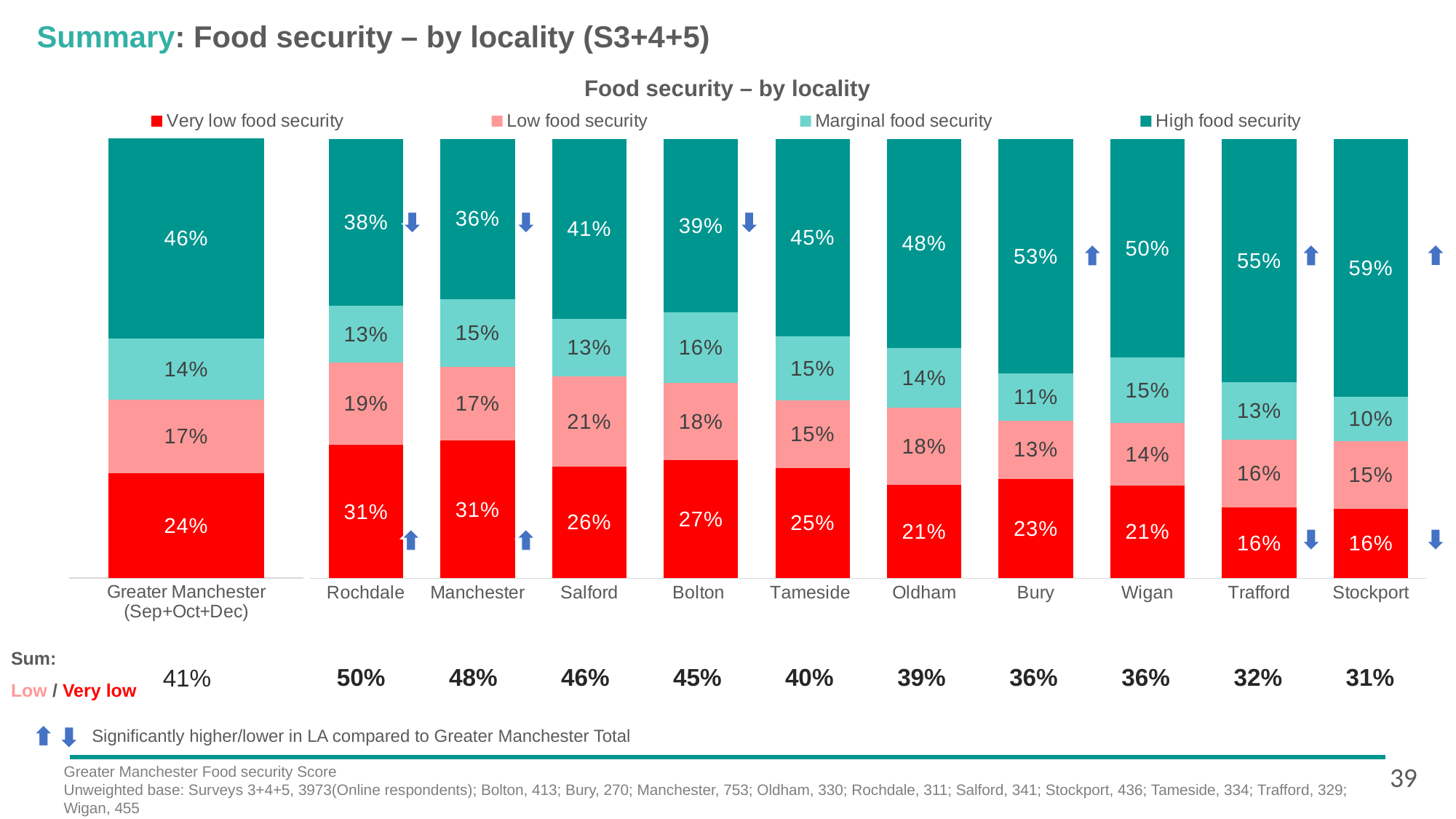
Which locality has the highest High food security value? Stockport What kind of chart is shown on the slide? Stacked bar chart Which has a larger Very low food security value, Bury or Wigan? Bury What is the Very low food security value for Rochdale? 31% What is the High food security value for Greater Manchester (Sep+Oct+Dec)? 46% What is the Low food security value for Salford? 21% Which locality has the lowest Marginal food security value? Stockport What is the combined Low and Very low food security value for Rochdale? 50% What is the Marginal food security value for Bolton? 16% What is the difference between the High food security values for Stockport and Manchester? 23% How many localities are shown on the x axis? 11 How many series does the legend list? 4